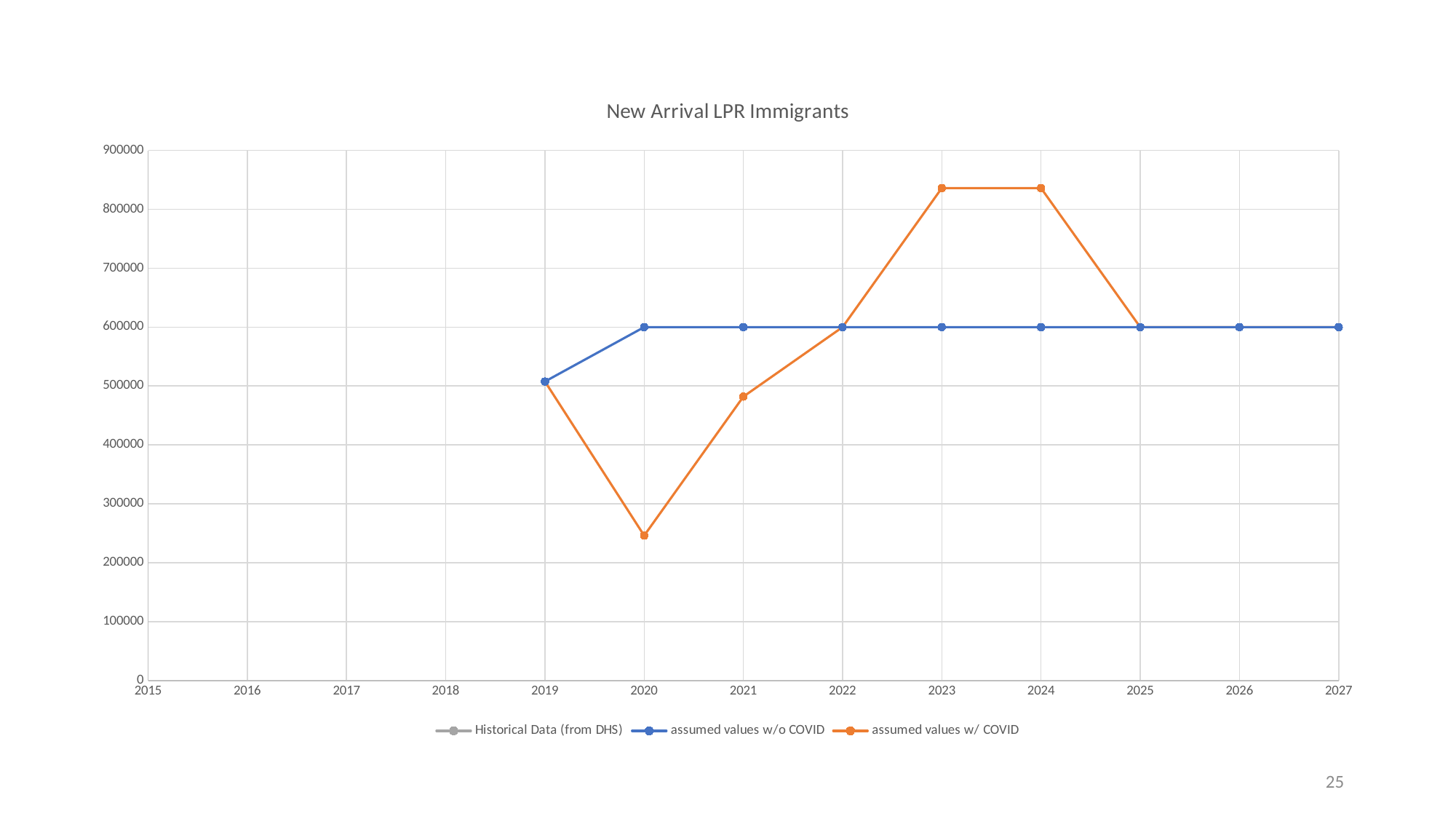
Is the value for 'assumed values w/ COVID' in 2023 greater or less than 800000? greater Is the value for 'assumed values w/o COVID' in 2019 greater or less than 600000? less Is the value for 'assumed values w/ COVID' in 2021 greater or less than 500000? less In 2020, which series has the larger value: 'assumed values w/o COVID' or 'assumed values w/ COVID'? assumed values w/o COVID Does the 'assumed values w/ COVID' series rise or fall from 2020 to 2023? rise What type of chart is shown on the slide? line chart Which series is drawn in orange? assumed values w/ COVID How many series does the legend list? 3 What is the title of the chart? New Arrival LPR Immigrants In which year does the 'assumed values w/ COVID' series reach its lowest value? 2020